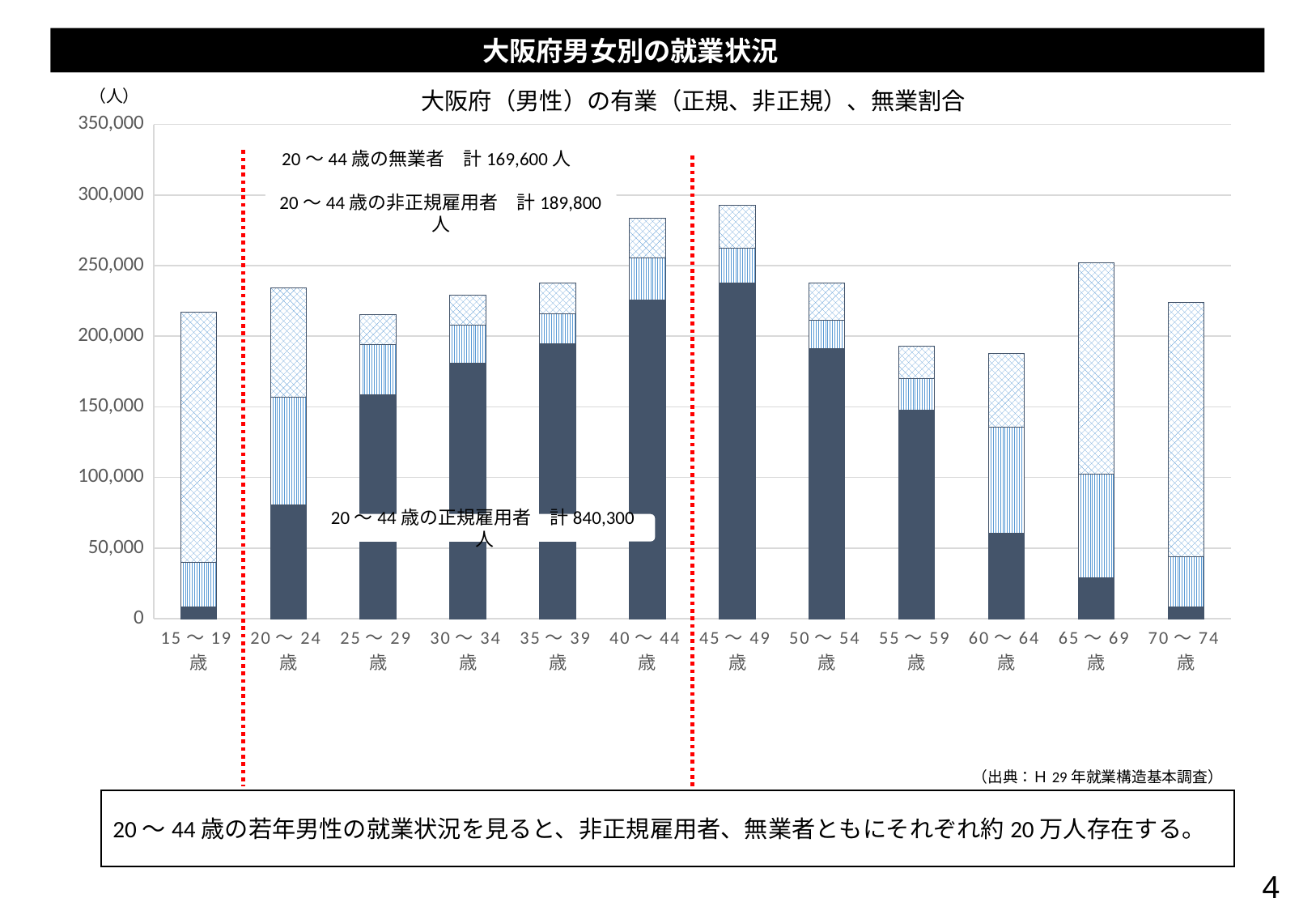
Is the total height of the bar for 55～59歳 greater or less than 200,000? less How many age-group categories are shown on the x axis? 12 According to the annotation, what is the total number of 無業者 aged 20～44歳? 169,600人 Is the total height of the bar for 45～49歳 greater or less than 250,000? greater What unit is shown at the top of the vertical axis? （人） What is the title of the chart? 大阪府（男性）の有業（正規、非正規）、無業割合 Which bar is taller in total, 65～69歳 or 60～64歳? 65～69歳 Is the total height of the bar for 15～19歳 greater or less than 200,000? greater What kind of chart is shown on the slide? Stacked bar chart According to the annotation, what is the total number of 正規雇用者 aged 20～44歳? 840,300人 According to the annotation, what is the total number of 非正規雇用者 aged 20～44歳? 189,800人